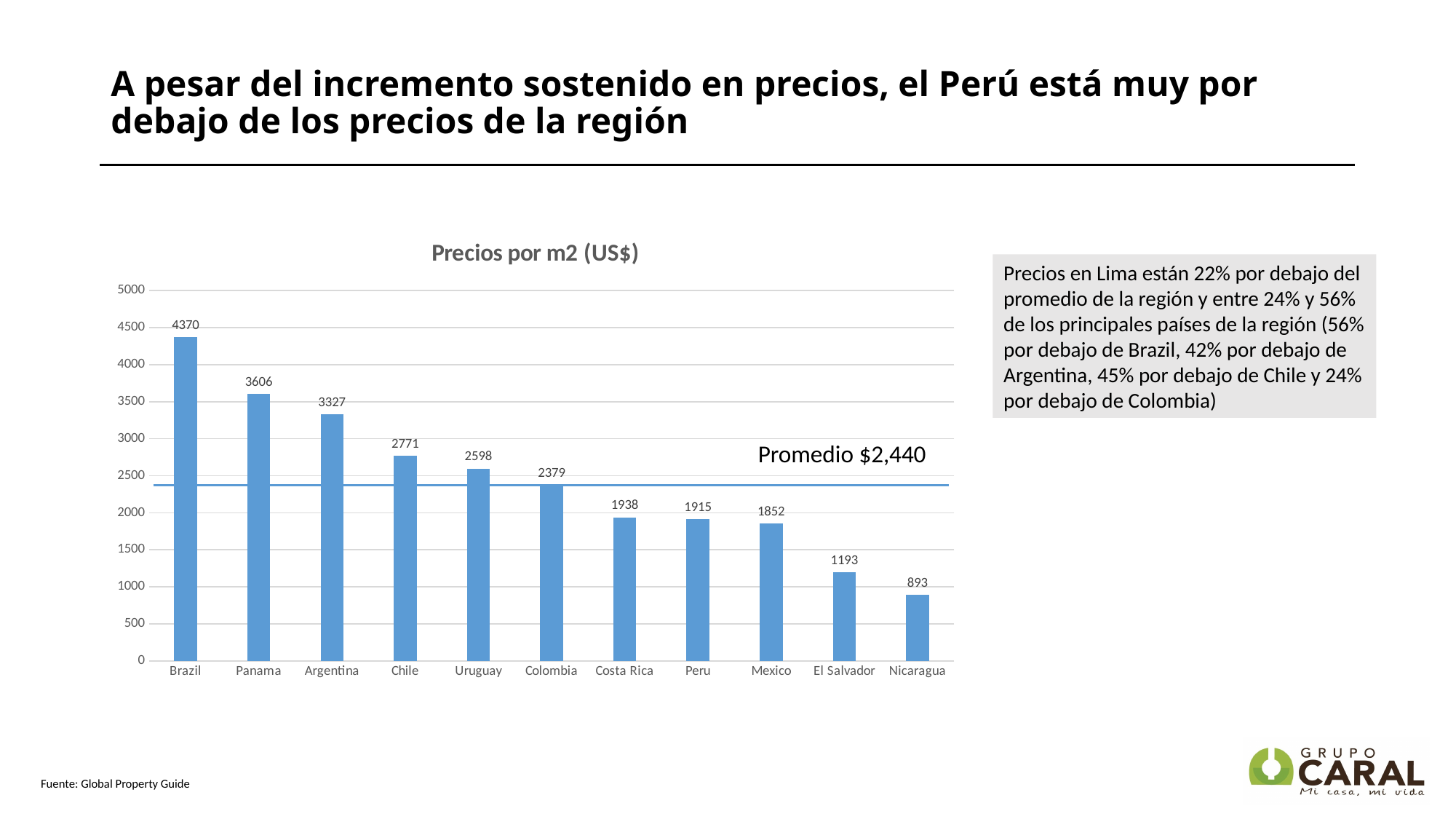
What is the difference between the values for Brazil and Peru? 2455 Which is larger, the value for Uruguay or the value for Colombia? Uruguay What kind of chart is shown on the slide? bar chart How many countries are shown in the chart? 11 What is the title of the chart? Precios por m2 (US$) What average value (Promedio) is marked by the horizontal line on the chart? $2,440 Which country has the lowest price per m2? Nicaragua Do the values rise or fall from left to right along the x axis? fall Which country has the highest price per m2? Brazil What is the value for Chile in the chart? 2771 What is the value for Peru in the chart? 1915 Is the value for Mexico greater or less than 2000? less